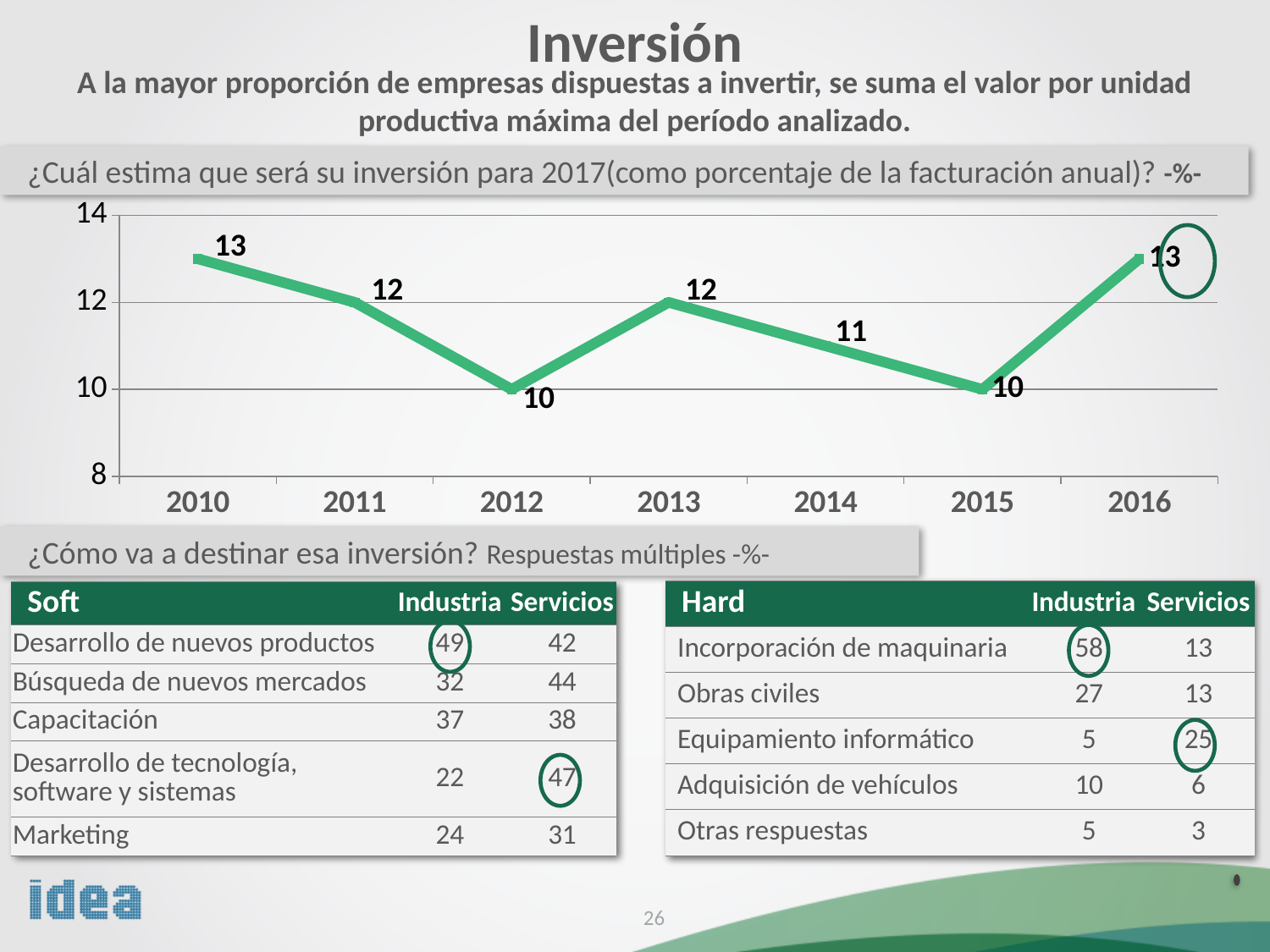
What is the value plotted for 2014? 11 What is the difference between the values for 2016 and 2015? 3 What is the value plotted for 2012? 10 What is the lowest value plotted on the line chart? 10 What is the estimated investment value for 2010? 13 How many years are plotted on the x axis of the line chart? 7 Does the line rise or fall from 2015 to 2016? rise What is the question shown as the title above the line chart? ¿Cuál estima que será su inversión para 2017(como porcentaje de la facturación anual)? -%- What type of chart is shown on the slide? line chart What is the highest value plotted on the line chart? 13 What is the value plotted for 2016? 13 Which year has the larger value, 2013 or 2014? 2013